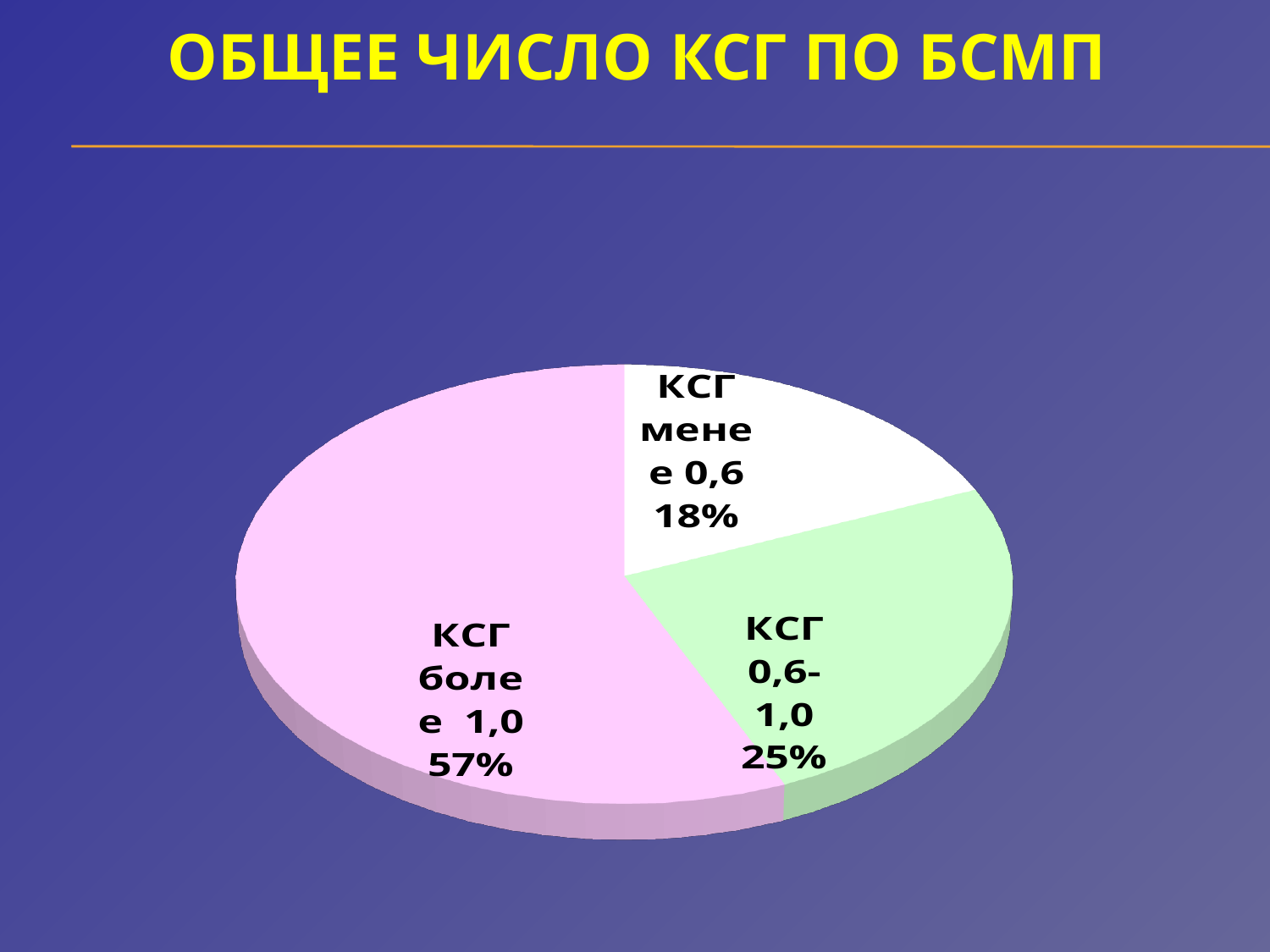
Which slice of the pie is the smallest? КСГ менее 0,6 What share of the pie does the slice "КСГ 0,6-1,0" have? 25% Which slice of the pie is the largest? КСГ более 1,0 What colour is the "КСГ 0,6-1,0" slice? light green How many slices does the pie chart have? 3 What share of the pie does the slice "КСГ менее 0,6" have? 18% Which slice is larger: "КСГ 0,6-1,0" or "КСГ менее 0,6"? КСГ 0,6-1,0 What kind of chart is shown on the slide? pie chart What is the difference in percentage points between the "КСГ более 1,0" slice and the "КСГ 0,6-1,0" slice? 32 What share of the pie does the slice "КСГ более 1,0" have? 57% What is the difference in percentage points between the "КСГ 0,6-1,0" slice and the "КСГ менее 0,6" slice? 7 What is the title of the slide? ОБЩЕЕ ЧИСЛО КСГ ПО БСМП